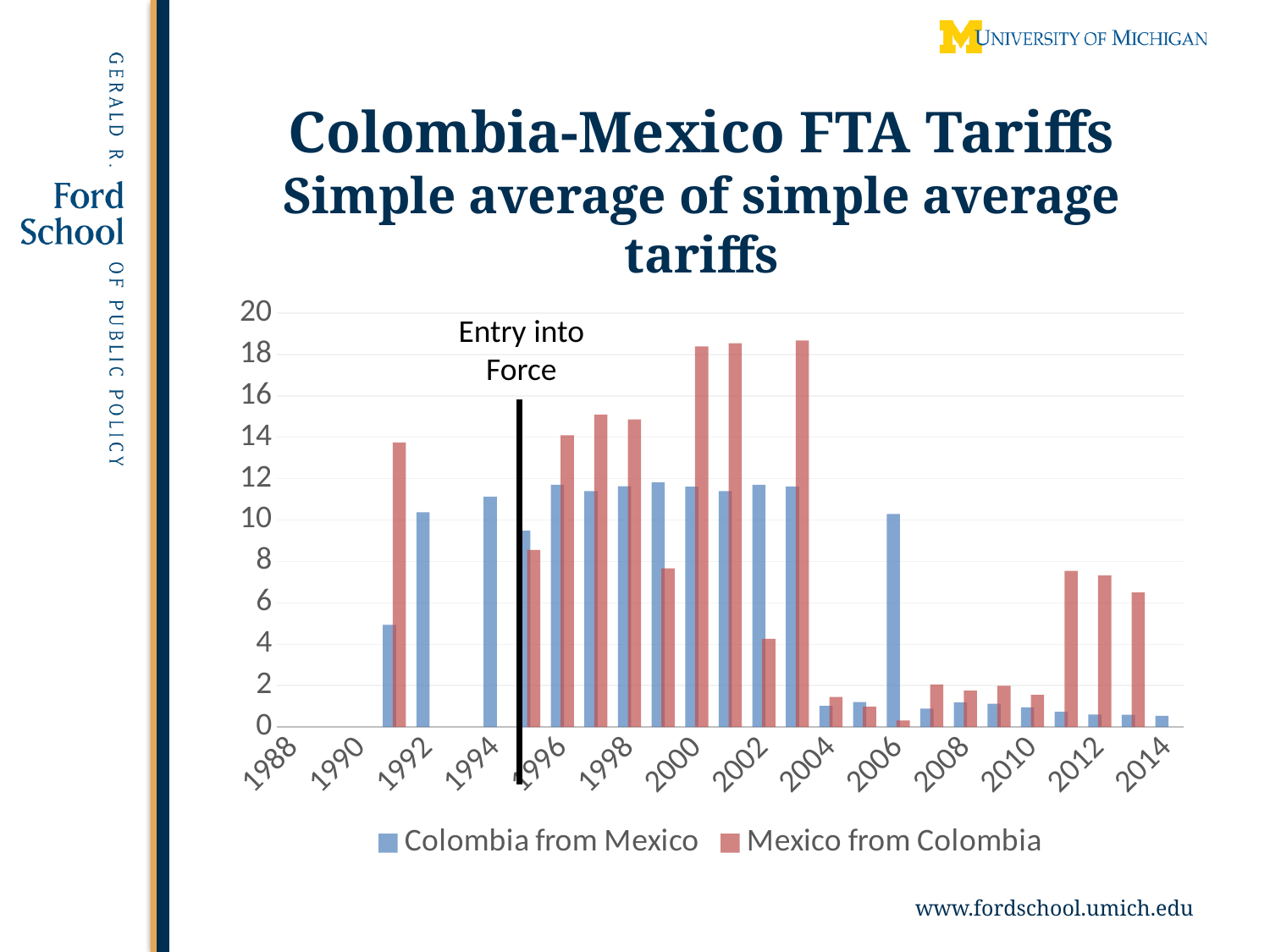
In 2000, which series has the larger value, Colombia from Mexico or Mexico from Colombia? Mexico from Colombia How many series does the legend list? 2 What does the annotation next to the vertical black line on the chart say? Entry into Force Is the value for Mexico from Colombia in 2000 greater or less than 16? greater What are the two series named in the legend? Colombia from Mexico and Mexico from Colombia Is the value for Colombia from Mexico in 2006 greater or less than 8? greater Is the value for Mexico from Colombia in 2002 greater or less than 6? less What kind of chart is shown on the slide? bar chart Do the Mexico from Colombia values rise or fall from 2011 to 2013? fall In 2006, which series has the larger value, Colombia from Mexico or Mexico from Colombia? Colombia from Mexico